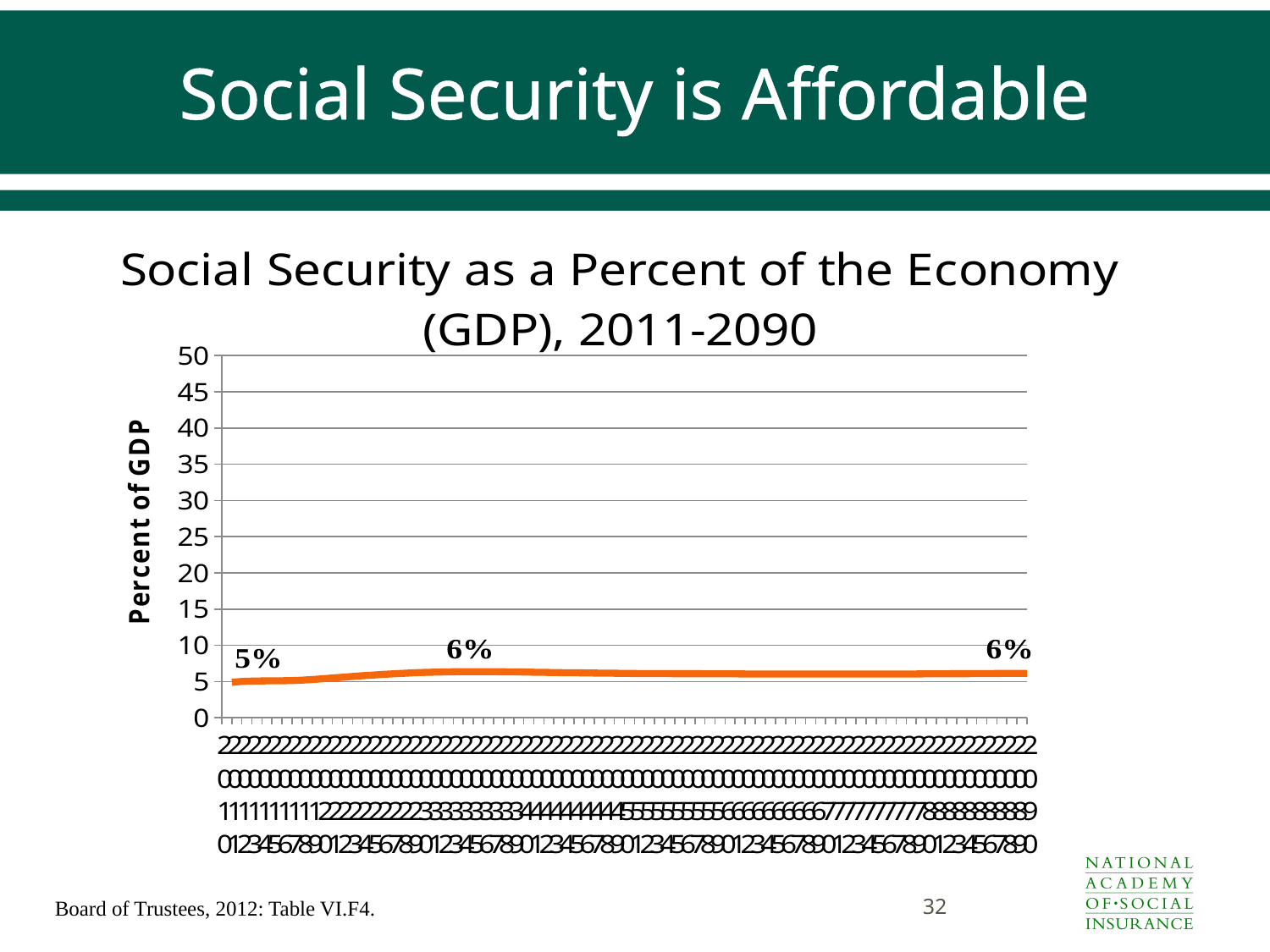
Which is larger, the labelled value for 2011 or the labelled value for 2090? 2090 What value is labelled at the start of the line, in 2011? 5% Is the value for 2011 greater or less than 10? less What value is labelled at the end of the line, in 2090? 6% Is the value for 2090 greater or less than 10? less What kind of chart is shown on the slide? line chart What is the difference between the labelled value for 2090 and the labelled value for 2011? 1% How many data labels are printed on the line? 3 Does the line rise or fall from 2011 to 2090? rise What is the label on the vertical axis of the chart? Percent of GDP Is the highest point on the line greater or less than 15? less What is the title of the chart? Social Security as a Percent of the Economy (GDP), 2011-2090